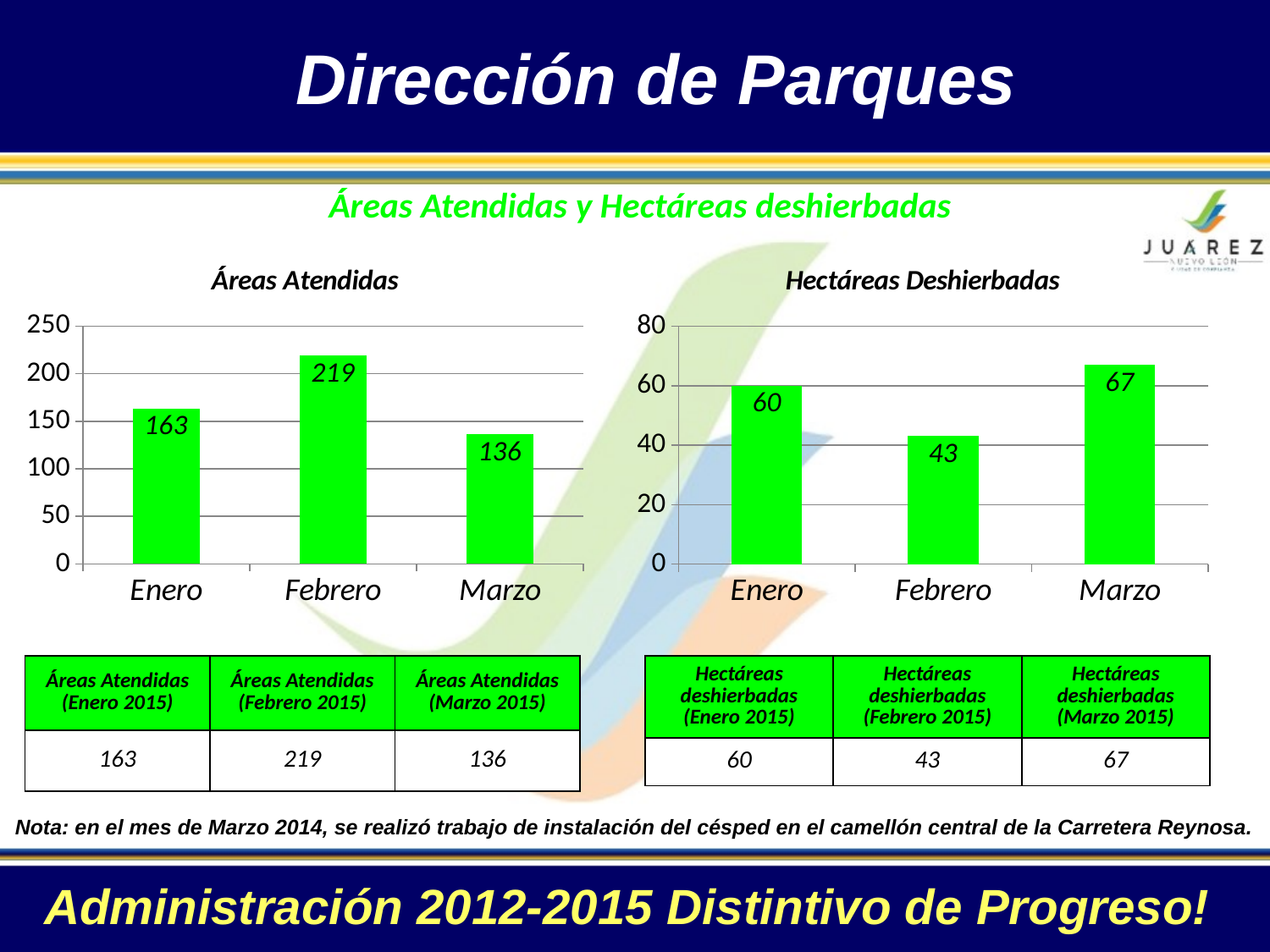
In the 'Áreas Atendidas' chart, which month has the highest value? Febrero In the 'Áreas Atendidas' chart, which is larger, the value for Enero or the value for Marzo? Enero How many months are shown in the 'Hectáreas Deshierbadas' chart? 3 In the 'Hectáreas Deshierbadas' chart, what is the value for Febrero? 43 In the 'Áreas Atendidas' chart, what is the value for Febrero? 219 In the 'Áreas Atendidas' chart, what is the difference between the values for Febrero and Marzo? 83 In the 'Hectáreas Deshierbadas' chart, what is the difference between the values for Marzo and Enero? 7 In the 'Hectáreas Deshierbadas' chart, what is the value for Enero? 60 What type of chart is the 'Áreas Atendidas' chart? Bar chart In the 'Hectáreas Deshierbadas' chart, is the value for Marzo greater or less than 60? greater In the 'Hectáreas Deshierbadas' chart, which month has the lowest value? Febrero In the 'Áreas Atendidas' chart, what is the value for Marzo? 136